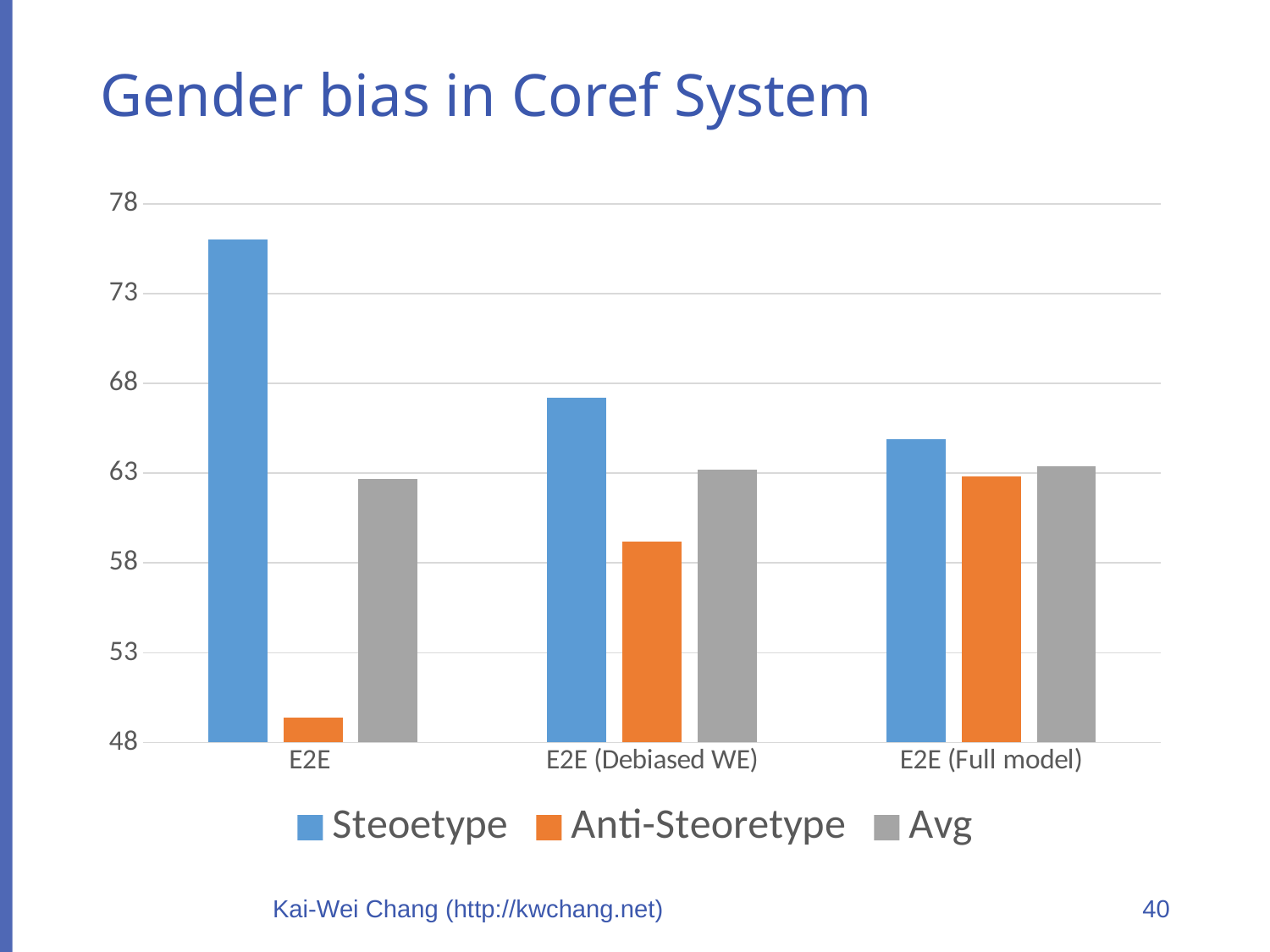
How many categories are shown on the x axis? 3 Is the Anti-Steoretype value for E2E greater or less than 53? less Do the Anti-Steoretype values rise or fall from E2E to E2E (Full model)? rise Which category has the highest Steoetype value? E2E Is the Steoetype value for E2E greater or less than 73? greater Which category has the lowest Anti-Steoretype value? E2E Which is larger for E2E (Full model): the Steoetype value or the Anti-Steoretype value? Steoetype What is the title of the chart? Gender bias in Coref System What kind of chart is shown on the slide? bar chart Is the Anti-Steoretype value for E2E (Debiased WE) greater or less than 58? greater How many series does the legend list? 3